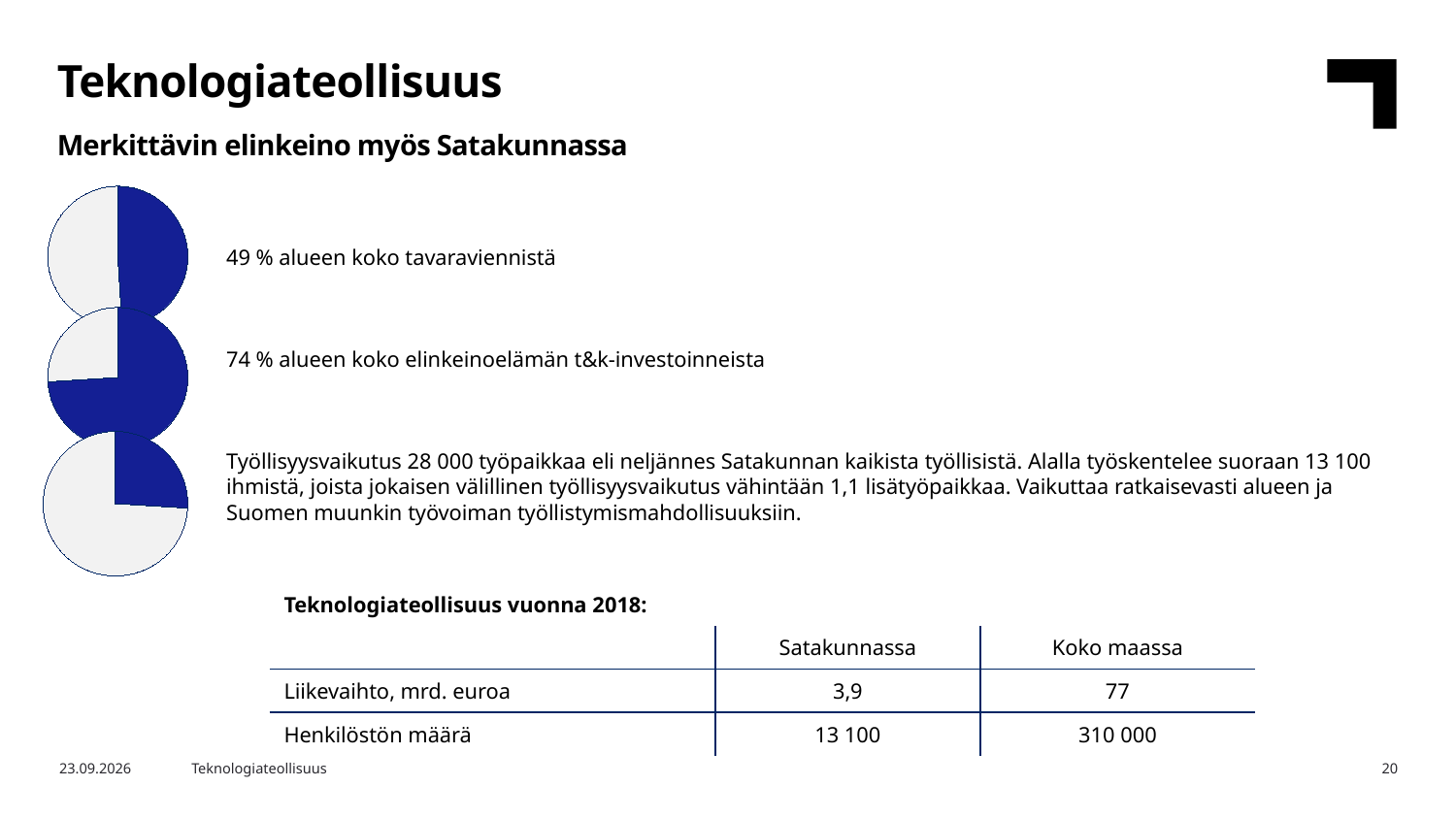
Is the highlighted slice larger in the top pie chart or in the middle pie chart? Middle pie chart In the middle pie chart, what share of the region's business R&D investments does the highlighted slice represent? 74 % Is the highlighted slice larger in the top pie chart or in the bottom pie chart? Top pie chart How many slices does each pie chart have? 2 Which of the three pie charts has the smallest highlighted slice? The bottom one (employment effect) What kind of charts are shown on the left side of the slide? Pie charts What colour is the highlighted slice in the pie charts? Blue How many pie charts are on the slide? 3 Which of the three pie charts has the largest highlighted slice? The middle one (74 % of R&D investments) In the top pie chart, what share of the region's total goods exports does the highlighted slice represent? 49 %